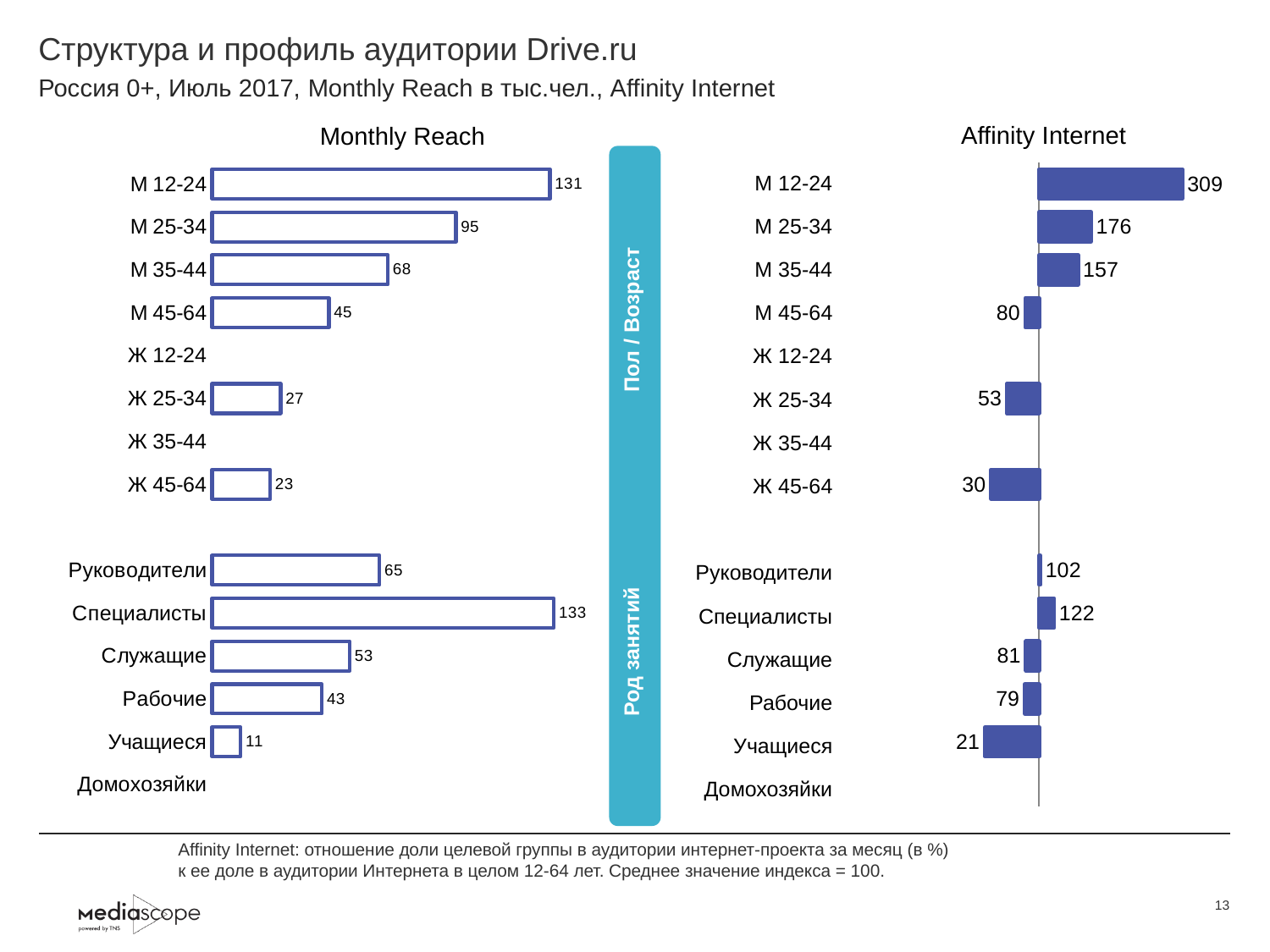
In the Affinity Internet chart, which is larger: the value for Ж 25-34 or the value for Ж 45-64? Ж 25-34 In the Affinity Internet chart, which category has the highest value? М 12-24 In the Monthly Reach chart, what is the difference between the values for М 12-24 and М 25-34? 36 What type of chart is the Monthly Reach chart? Bar chart In the Monthly Reach chart, which category among the occupation groups (Род занятий) has the lowest plotted value? Учащиеся In the Affinity Internet chart, what is the value for М 25-34? 176 In the Monthly Reach chart, what is the value for Рабочие? 43 In the Affinity Internet chart, what is the value for Учащиеся? 21 In the Monthly Reach chart, which is larger: the value for Руководители or the value for Служащие? Руководители In the Monthly Reach chart, what is the value for Специалисты? 133 In the Affinity Internet chart, what is the difference between the values for Специалисты and Руководители? 20 In the Monthly Reach chart, what is the value for М 12-24? 131